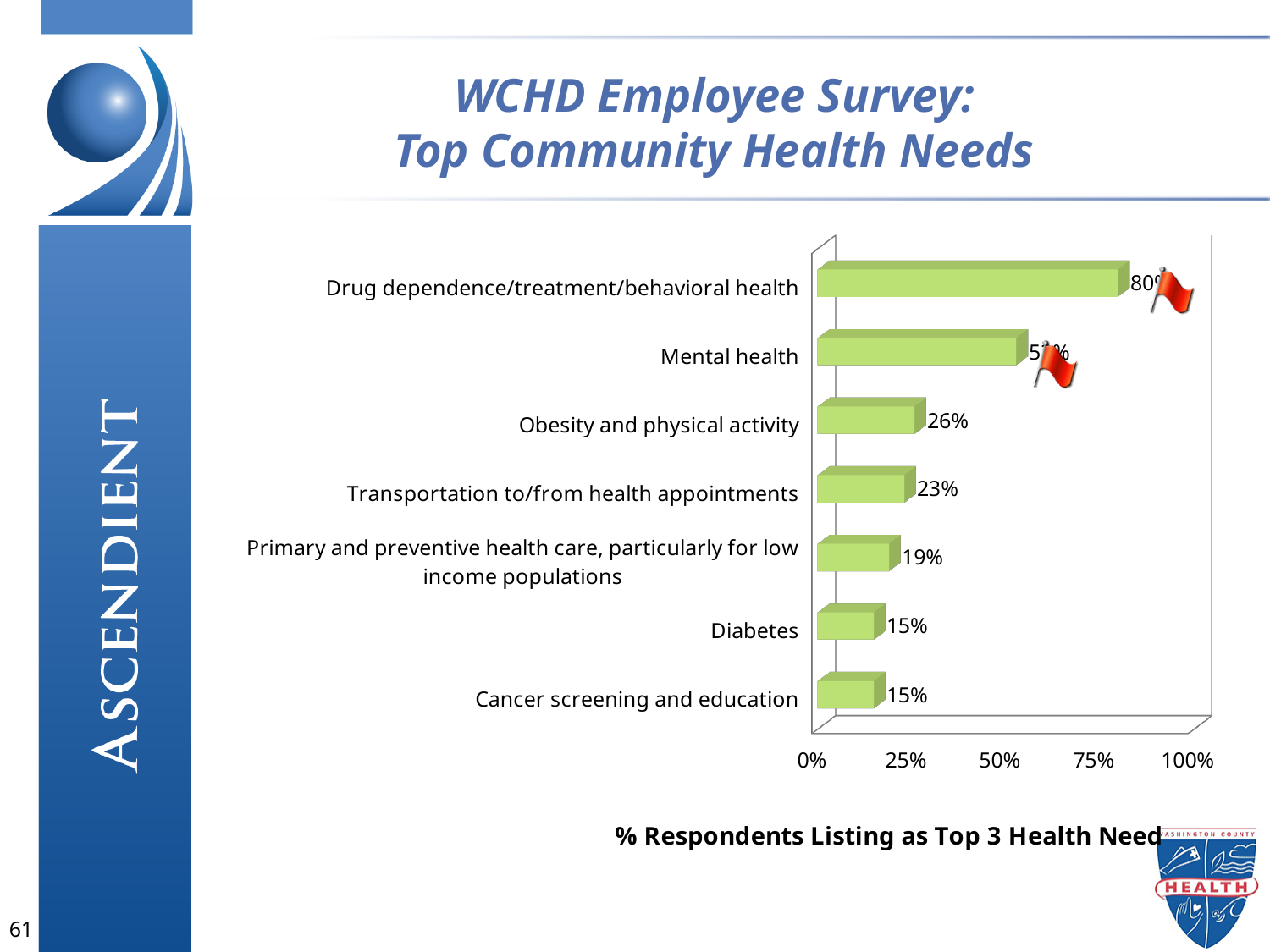
What type of chart is shown on the slide? bar chart What is the value for Cancer screening and education? 15% Is the value for Mental health greater or less than 25%? greater What percentage of respondents listed Obesity and physical activity as a top 3 health need? 26% Is the value for Drug dependence/treatment/behavioral health greater or less than 75%? greater What is the value for Transportation to/from health appointments? 23% Which health need has the highest percentage of respondents? Drug dependence/treatment/behavioral health Which has a larger value, Obesity and physical activity or Transportation to/from health appointments? Obesity and physical activity What is the difference between the values for Obesity and physical activity and Transportation to/from health appointments? 3% What is the value for Diabetes? 15% How many health needs are shown in the chart? 7 What is the value for Primary and preventive health care, particularly for low income populations? 19%